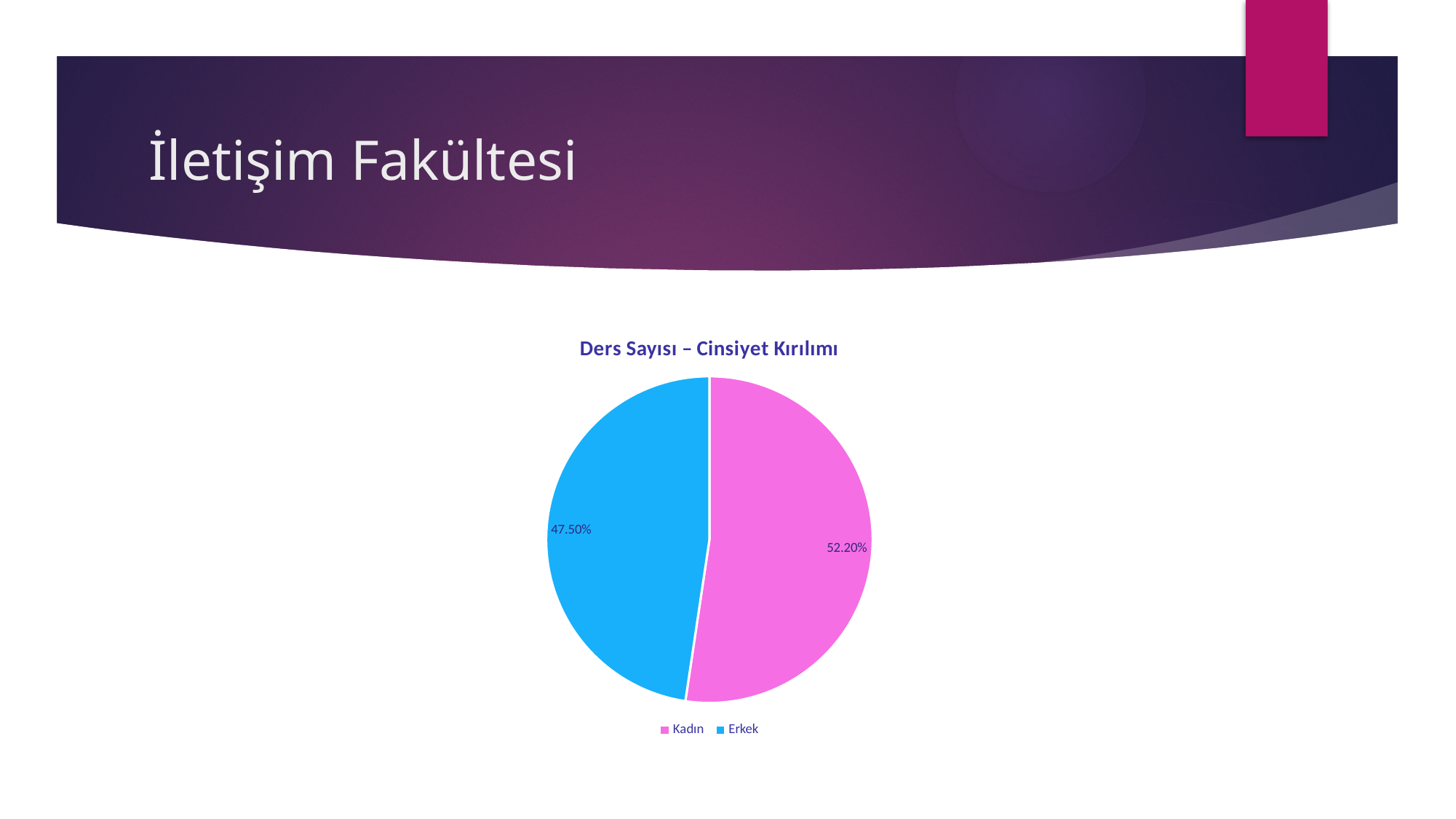
What is the title of the chart? Ders Sayısı – Cinsiyet Kırılımı What is the difference between the Kadın and Erkek shares? 4.70% What share of the pie does Kadın have? 52.20% How many entries does the legend list? 2 What share of the pie does Erkek have? 47.50% Which category has the largest slice of the pie? Kadın Which category has the smallest slice of the pie? Erkek What colour is the Erkek slice? Blue How many slices does the pie chart have? 2 What kind of chart is shown on the slide? Pie chart Which is larger, the Kadın slice or the Erkek slice? Kadın